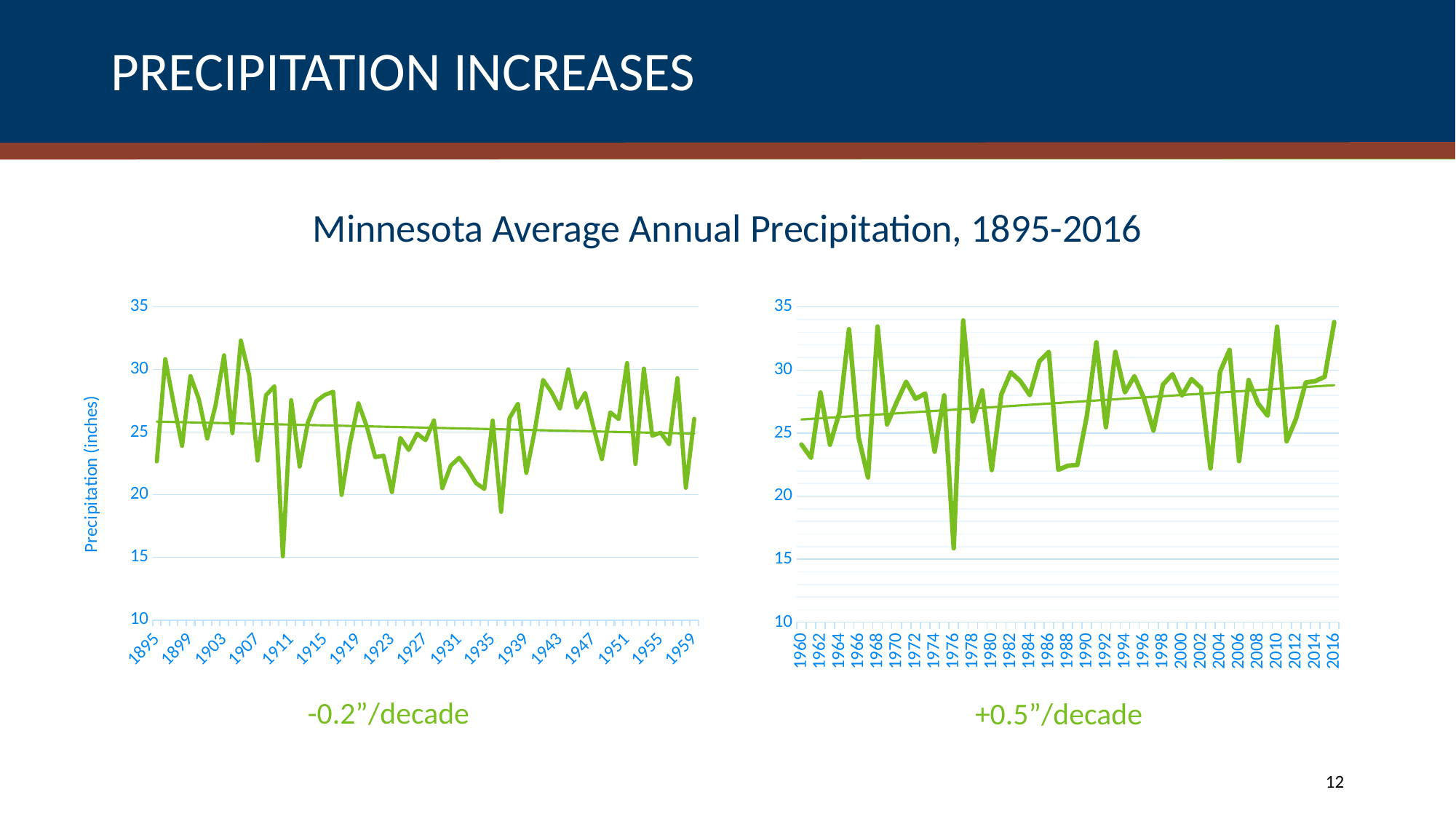
What trend rate per decade is printed below the right chart (1960-2016)? +0.5"/decade In the right chart (1960-2016), which year has the lowest precipitation? 1976 What is the overall title shown above the two charts? Minnesota Average Annual Precipitation, 1895-2016 In the left chart (1895-1959), does the trend line rise or fall along the x axis? fall In the left chart (1895-1959), is the value for 1907 greater or less than 30? less What kind of chart is the left chart (1895-1959)? line chart In the right chart (1960-2016), is the value for 1976 greater or less than 20? less In the left chart (1895-1959), is the value for 1911 greater or less than 20? greater In the left chart (1895-1959), which year has the lowest precipitation? 1910 In the right chart (1960-2016), does the trend line rise or fall along the x axis? rise What kind of chart is the right chart (1960-2016)? line chart